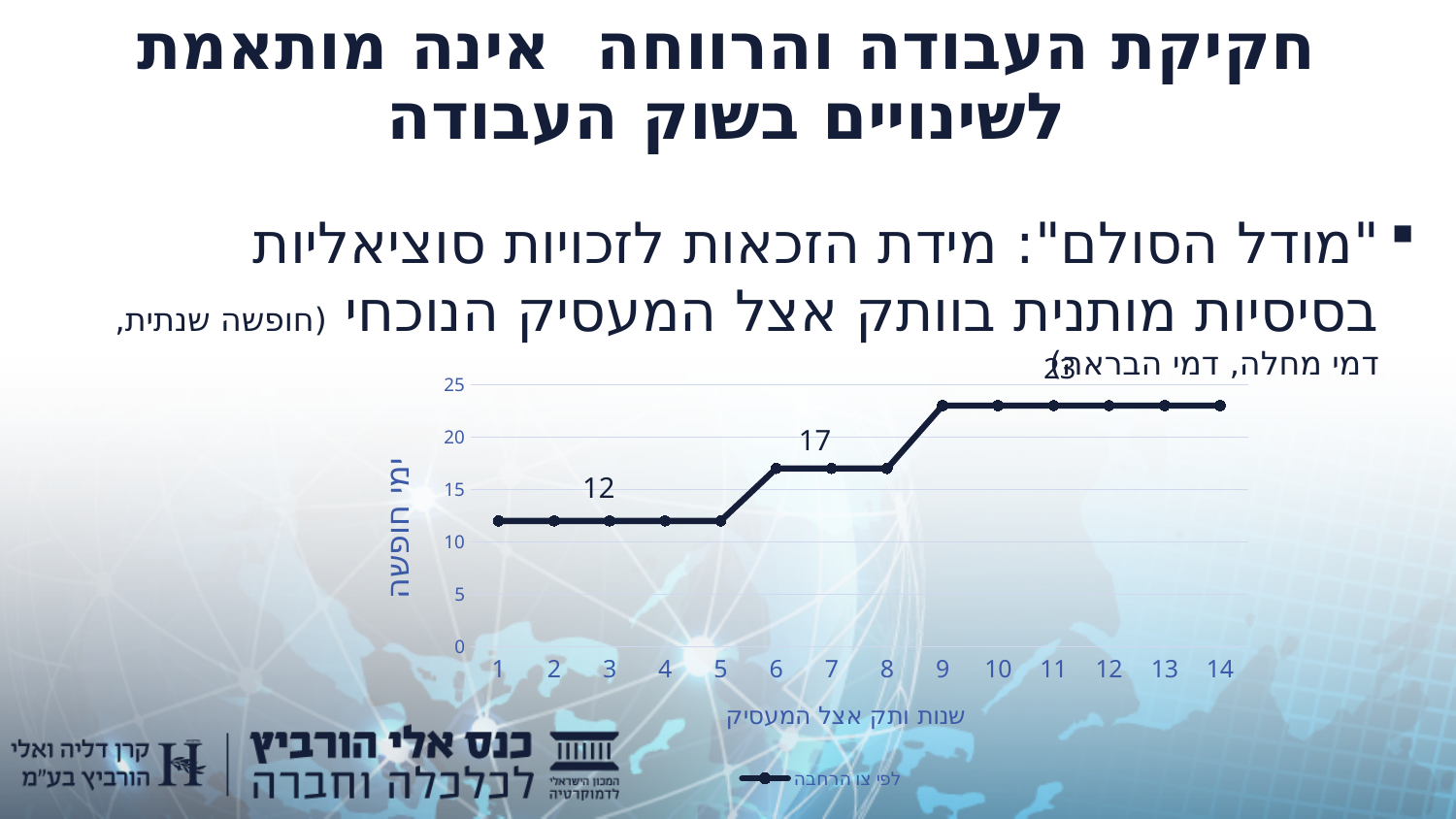
What kind of chart is shown on the slide? line chart What is the difference between the value at 6 years and the value at 3 years of seniority? 5 What is the lowest value plotted on the chart? 12 Is the value for 10 years of seniority greater or less than 20? greater How many seniority years (points) are plotted on the x axis? 14 What is the value of vacation days (ימי חופשה) at 1 year of seniority? 12 What is the value of vacation days at 7 years of seniority? 17 What is the title of the x axis? שנות ותק אצל המעסיק Is the value for 3 years of seniority greater or less than 15? less Do the values rise or fall as seniority years increase along the x axis? rise Which has a larger value: 8 years of seniority or 4 years of seniority? 8 years How many series does the legend list? 1